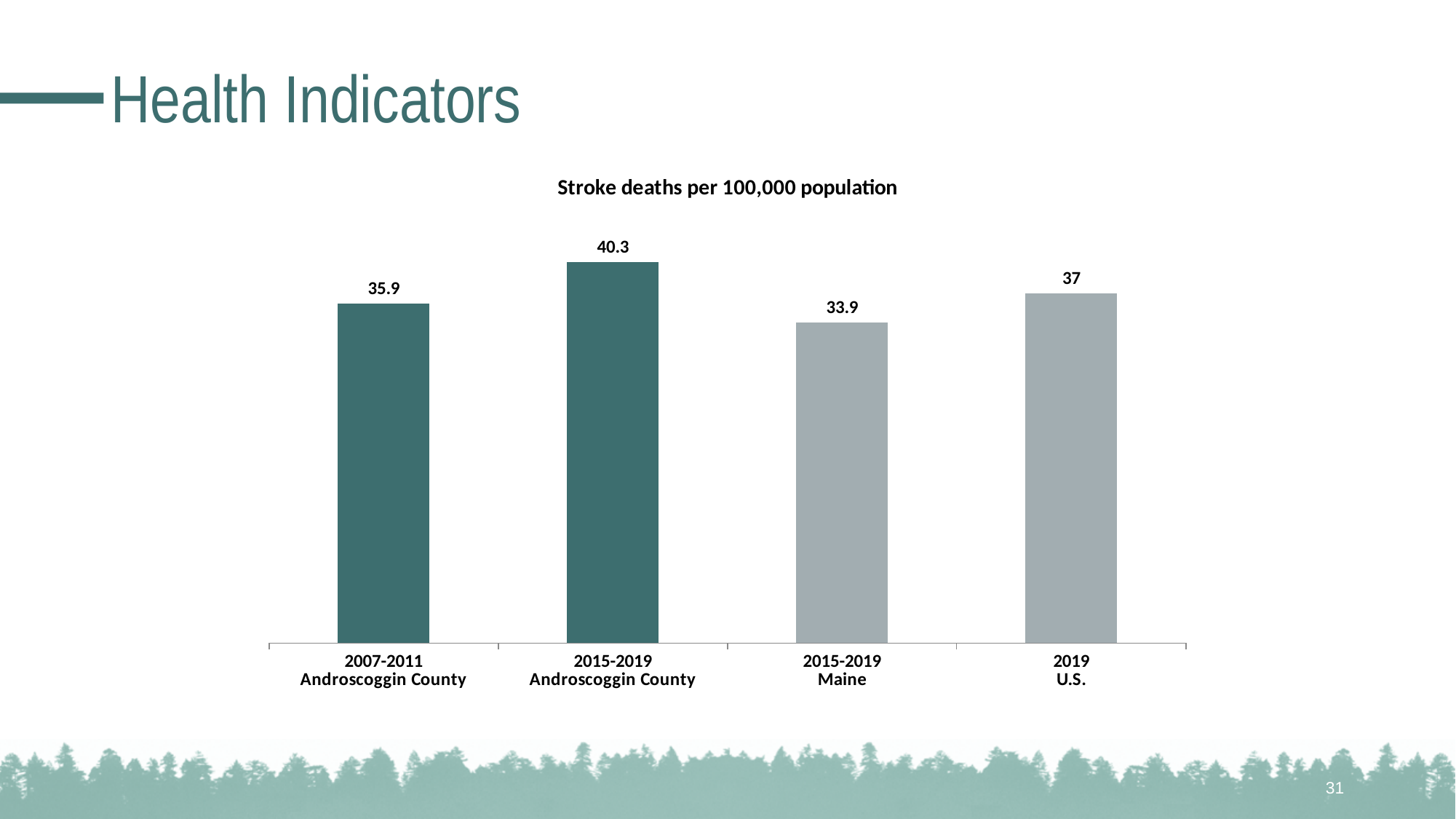
What is the difference between the 2015-2019 Androscoggin County value and the 2007-2011 Androscoggin County value? 4.4 What is the title of the chart? Stroke deaths per 100,000 population What kind of chart is shown on the slide? Bar chart Which is larger, the value for 2019 U.S. or the value for 2007-2011 Androscoggin County? 2019 U.S. How many bars are shown in the chart? 4 Which category has the lowest value? 2015-2019 Maine What is the value for 2015-2019 Maine? 33.9 What is the value for 2015-2019 Androscoggin County? 40.3 What is the value for 2007-2011 Androscoggin County? 35.9 What is the difference between the 2019 U.S. value and the 2015-2019 Maine value? 3.1 Which category has the highest value? 2015-2019 Androscoggin County What is the value for 2019 U.S.? 37